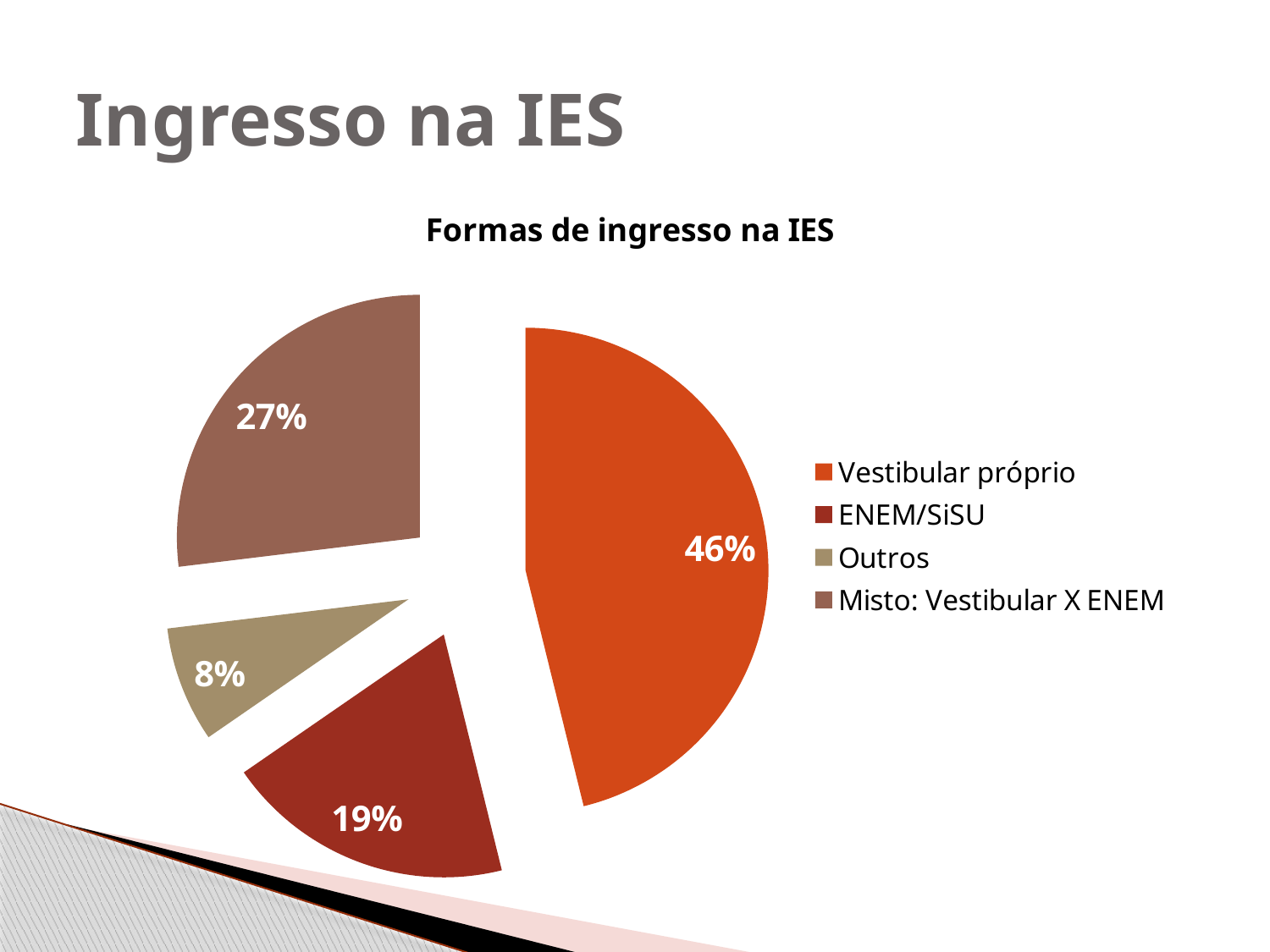
What kind of chart is shown on the slide? pie chart What share of the pie does ENEM/SiSU have? 19% What is the title of the chart? Formas de ingresso na IES Which category has the largest slice of the pie? Vestibular próprio How many categories does the legend list? 4 What is the difference in percentage points between Vestibular próprio and Misto: Vestibular X ENEM? 19 Which is larger, the slice for ENEM/SiSU or the slice for Misto: Vestibular X ENEM? Misto: Vestibular X ENEM What share of the pie does Vestibular próprio have? 46% What colour is the slice for Vestibular próprio? orange What share of the pie does Misto: Vestibular X ENEM have? 27% Which category has the smallest slice of the pie? Outros